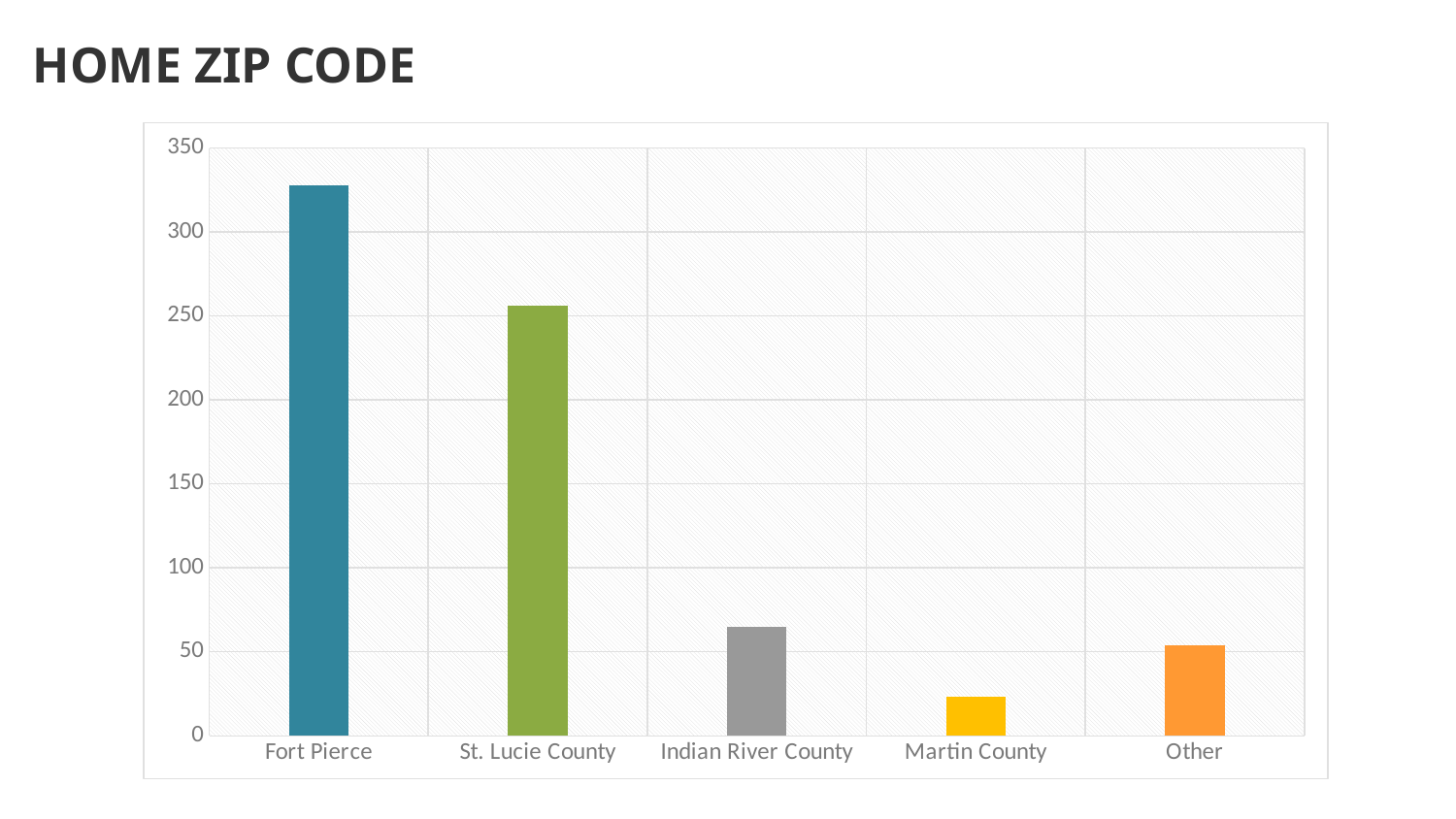
Is the value for Fort Pierce greater or less than 300? greater Which category has the lowest value? Martin County Is the value for St. Lucie County greater or less than 300? less Which is larger, the value for Martin County or the value for Other? Other Which is larger, the value for Fort Pierce or the value for St. Lucie County? Fort Pierce How many categories are shown on the x axis? 5 Is the value for Martin County greater or less than 50? less What is the title of the slide? HOME ZIP CODE What kind of chart is shown on the slide? bar chart Which category has the highest value? Fort Pierce